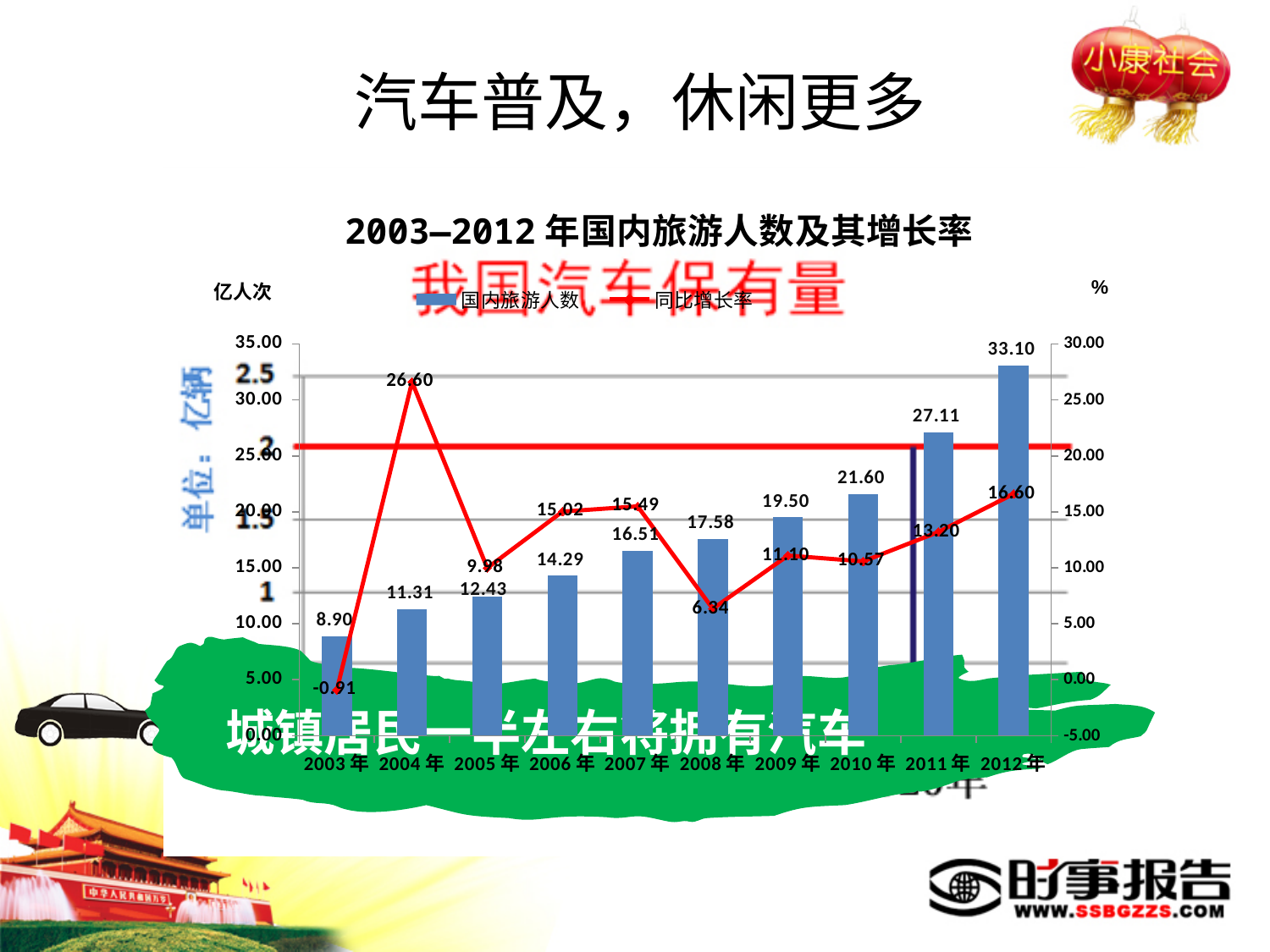
How many years are shown on the x axis? 10 Do the 国内旅游人数 bars rise or fall from 2003年 to 2012年? rise What is the difference between the 国内旅游人数 values for 2012年 and 2011年? 5.99 Which is larger, the 同比增长率 for 2007年 or for 2008年? 2007年 What is the 国内旅游人数 value for 2008年? 17.58 What is the 同比增长率 value for 2004年? 26.60 What is the 同比增长率 value for 2003年? -0.91 Which year has the highest 同比增长率? 2004年 How many series does the legend list? 2 Which year has the lowest 国内旅游人数? 2003年 What is the 国内旅游人数 value for 2012年? 33.10 What is the title of the chart? 2003–2012年国内旅游人数及其增长率